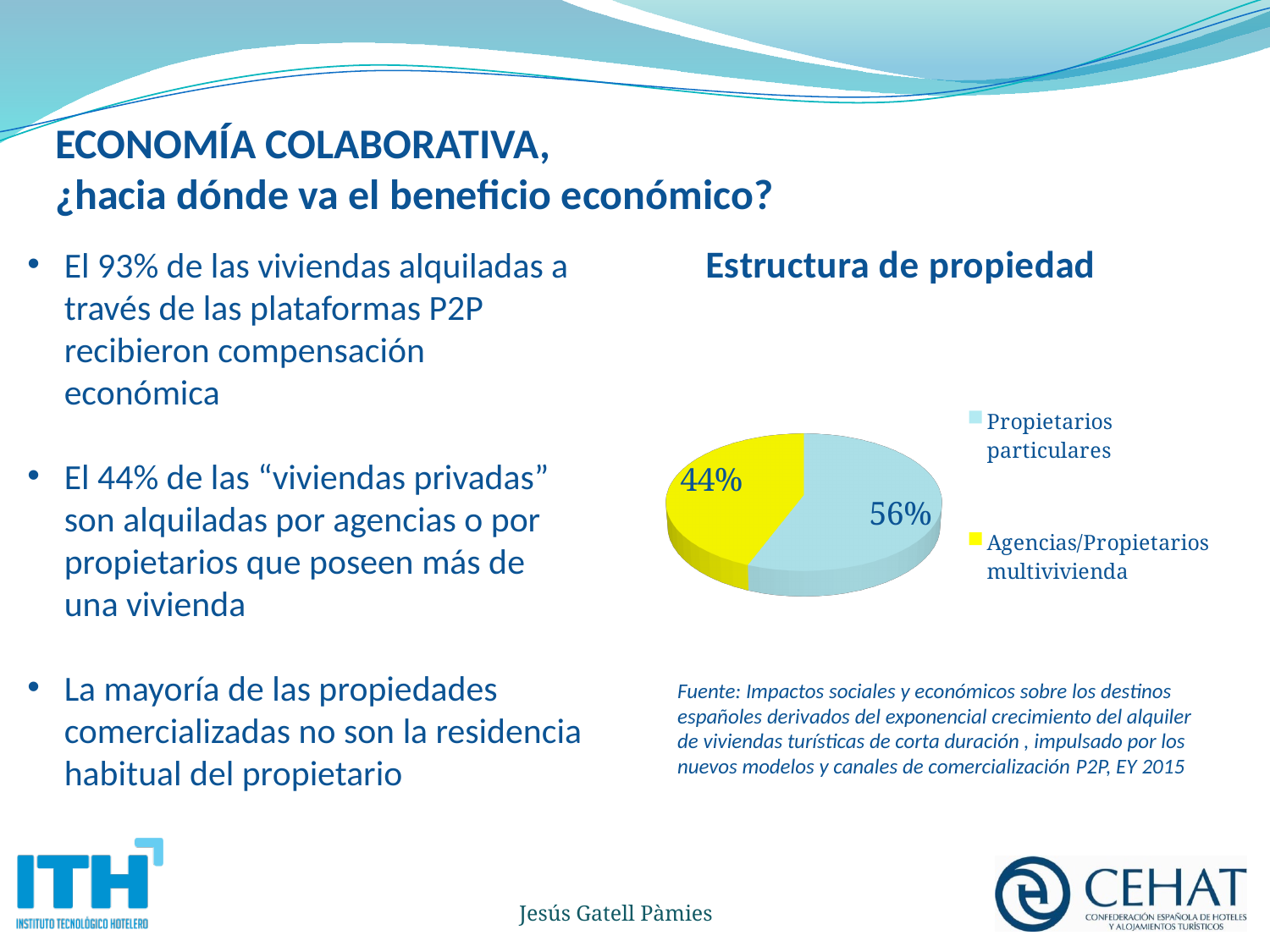
How many slices does the pie chart have? 2 What share of the pie does "Propietarios particulares" represent? 56% Which is larger: the slice for "Propietarios particulares" or the slice for "Agencias/Propietarios multivivienda"? Propietarios particulares What share of the pie does "Agencias/Propietarios multivivienda" represent? 44% What colour is the slice for "Agencias/Propietarios multivivienda"? yellow Which category has the smallest slice of the pie? Agencias/Propietarios multivivienda How many entries does the legend of the pie chart list? 2 What kind of chart is shown under the title "Estructura de propiedad"? pie chart What is the title of the pie chart? Estructura de propiedad What is the difference in percentage points between the "Propietarios particulares" slice and the "Agencias/Propietarios multivivienda" slice? 12% Which category has the largest slice of the pie? Propietarios particulares